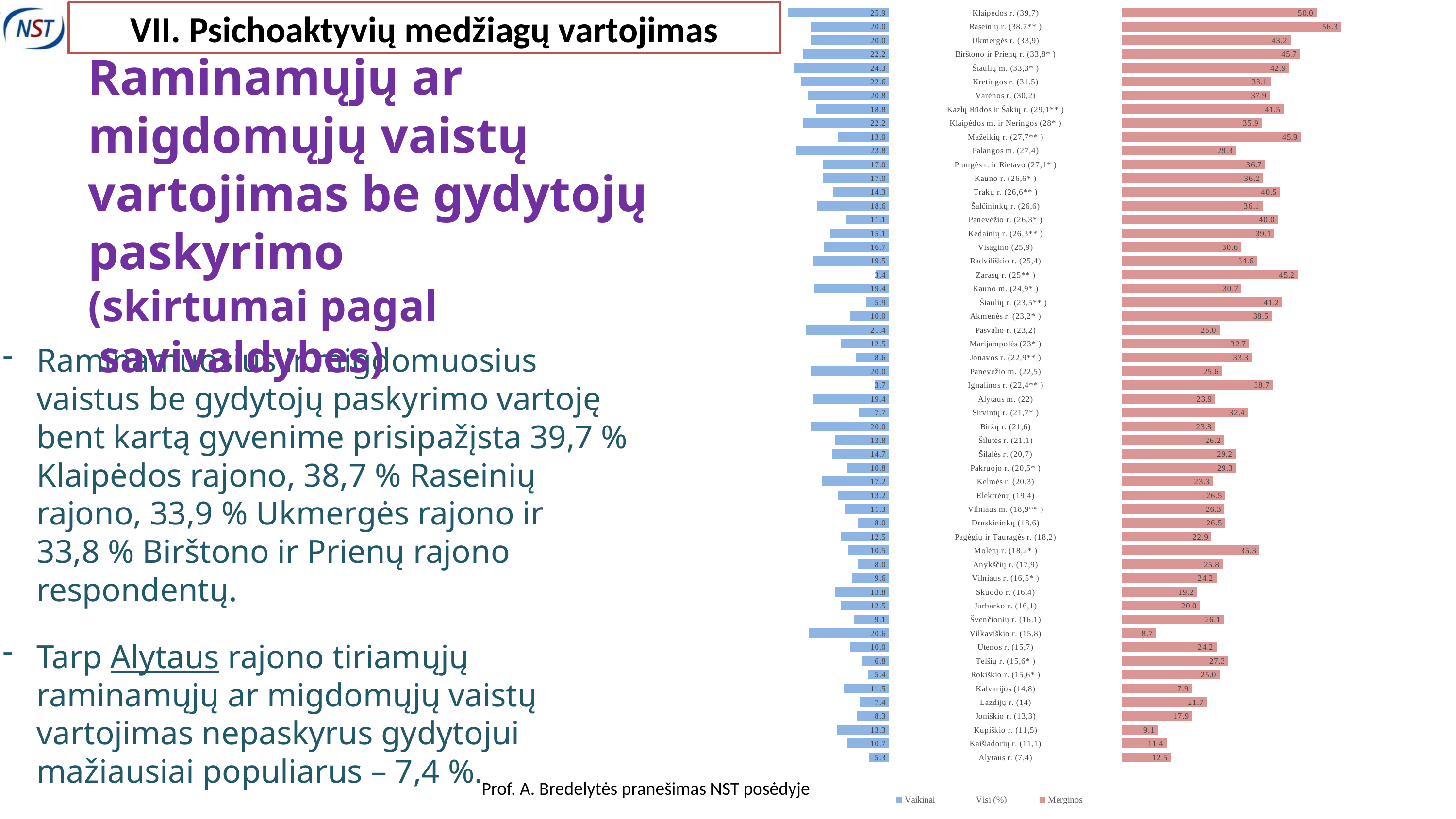
Which municipality has the highest Merginos value? Raseinių r. (38,7**) How many entries does the chart legend list? 3 Which colour represents the Merginos series in the chart? pink What is the Merginos value for Alytaus r. (7,4)? 12.5 What is the difference between the Merginos and Vaikinai values for Raseinių r. (38,7**)? 36.3 What is the Vaikinai value for Ukmergės r. (33,9)? 20.0 For Vilkaviškio r. (15,8), which series has the larger value, Vaikinai or Merginos? Vaikinai Which municipality has the lowest Merginos value? Vilkaviškio r. (15,8) What kind of chart is shown on the slide? bar chart What is the Merginos value for Klaipėdos r. (39,7)? 50.0 What is the Vaikinai value for Alytaus r. (7,4)? 5.3 Which municipality has the highest Vaikinai value? Klaipėdos r. (39,7)